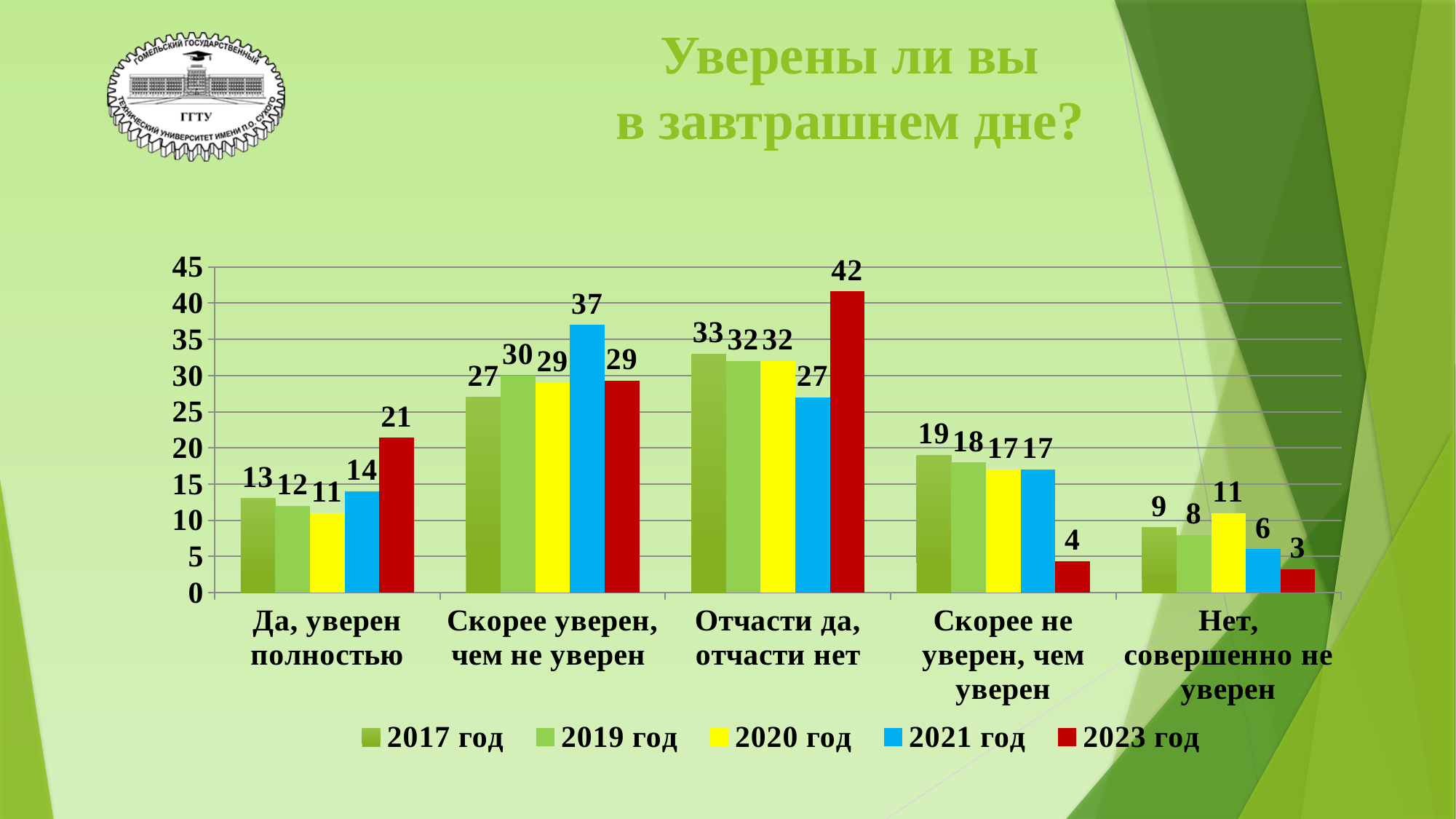
Which category has the highest value for 2023 год? Отчасти да, отчасти нет What kind of chart is shown on the slide? bar chart What is the title of the chart? Уверены ли вы в завтрашнем дне? What is the value for 2021 год in the category 'Скорее уверен, чем не уверен'? 37 Which colour represents the series 2023 год in the legend? red What is the value for 2023 год in the category 'Отчасти да, отчасти нет'? 42 How many series does the legend list? 5 In the category 'Скорее не уверен, чем уверен', which is larger: the value for 2017 год or for 2023 год? 2017 год What is the difference between the 2023 год and 2021 год values in the category 'Да, уверен полностью'? 7 How many categories are shown on the x axis? 5 Which category has the lowest value for 2017 год? Нет, совершенно не уверен What is the value for 2020 год in the category 'Да, уверен полностью'? 11